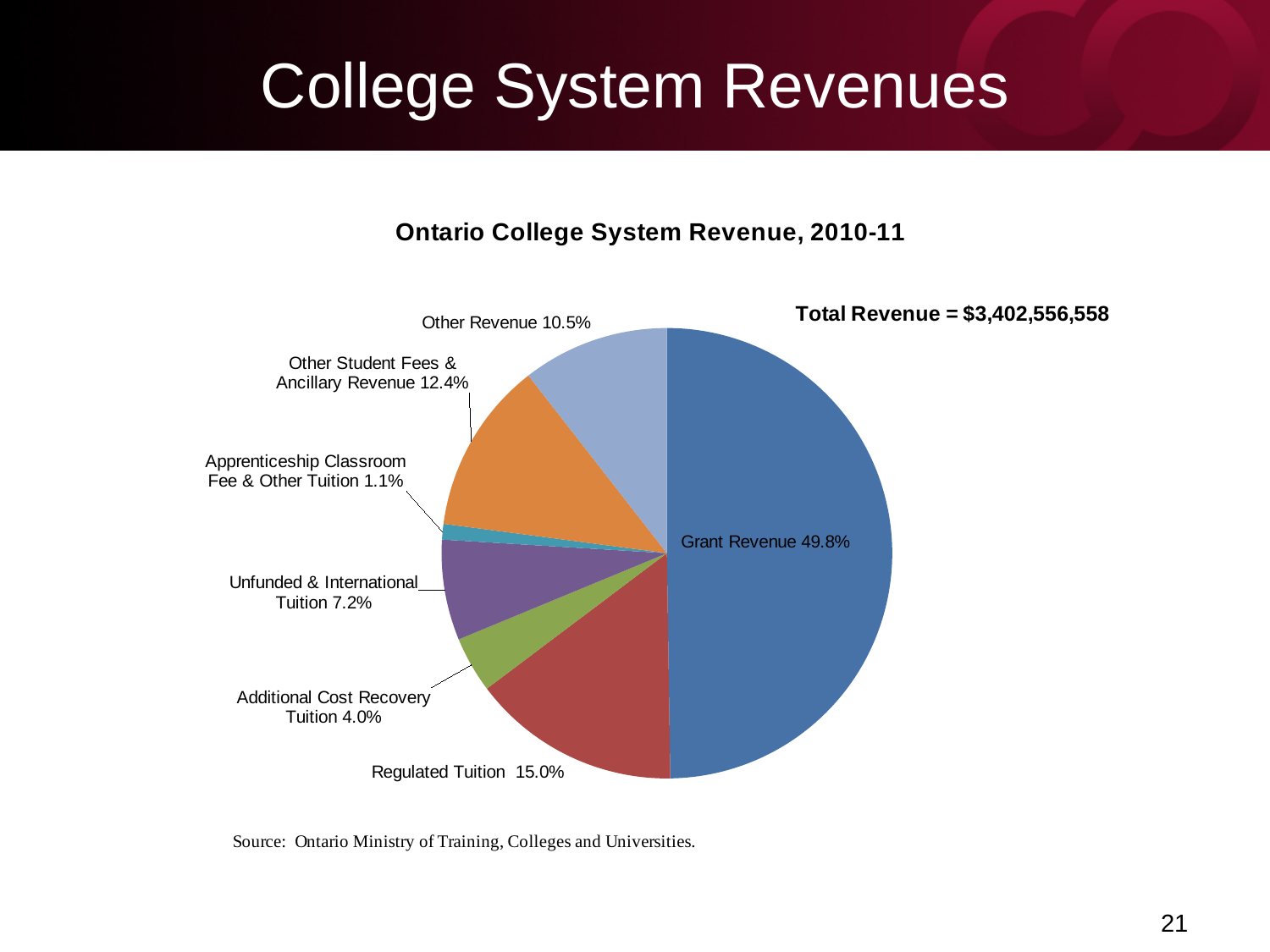
What is the total revenue stated on the slide? $3,402,556,558 What is the difference in percentage points between Regulated Tuition and Other Revenue? 4.5 What percentage of revenue comes from Regulated Tuition? 15.0% What share of revenue does Grant Revenue account for? 49.8% Which category has the smallest share of revenue? Apprenticeship Classroom Fee & Other Tuition What is the title of the chart? Ontario College System Revenue, 2010-11 What type of chart is shown on the slide? Pie chart Which is larger: Unfunded & International Tuition or Additional Cost Recovery Tuition? Unfunded & International Tuition Which category has the largest share of revenue? Grant Revenue How many slices does the pie chart have? 7 What is the share for Other Student Fees & Ancillary Revenue? 12.4% What percentage is shown for Apprenticeship Classroom Fee & Other Tuition? 1.1%